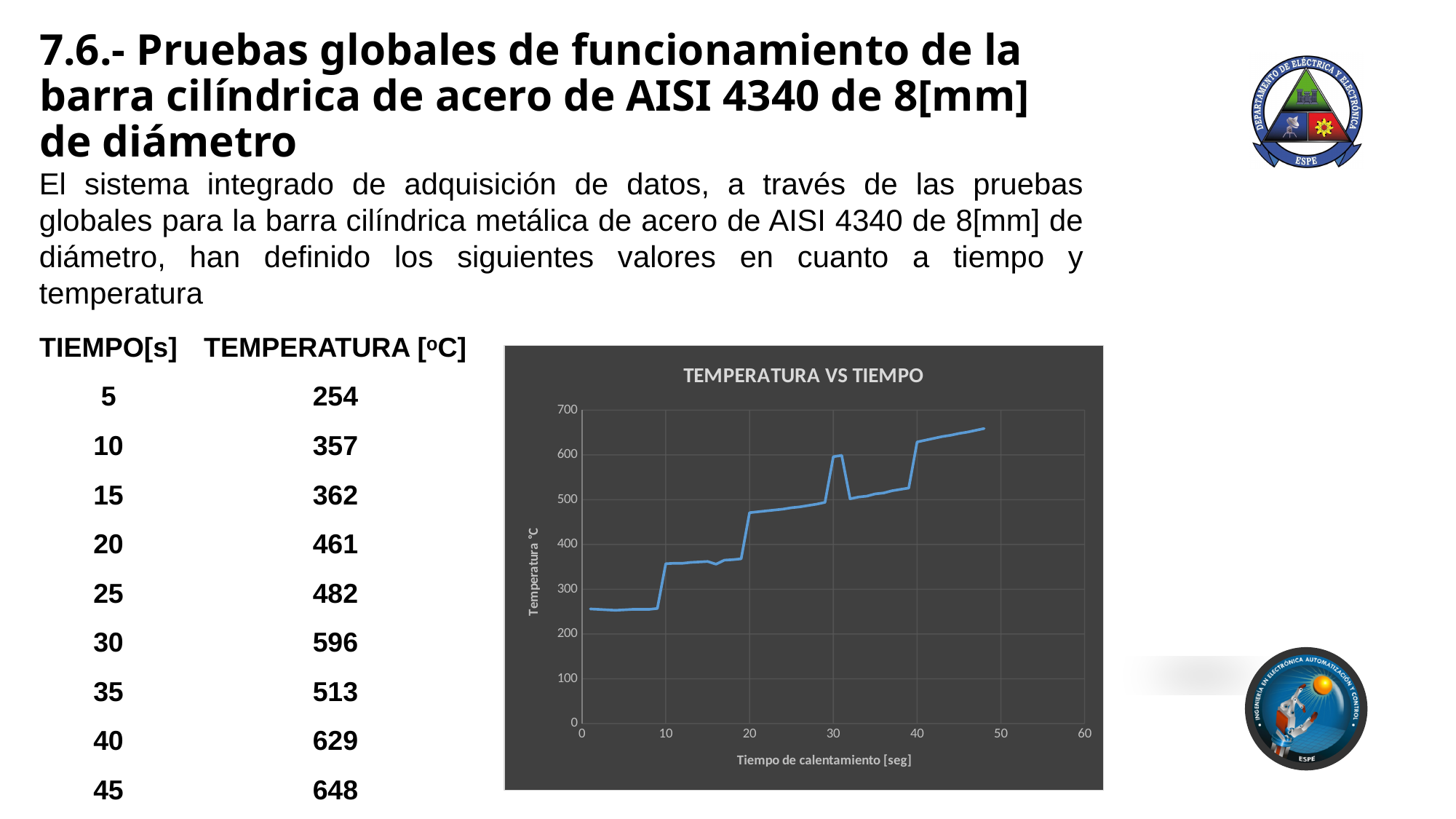
According to the table on the slide, at which time is the temperature highest? 45 According to the table on the slide, what is the temperature at 20 s? 461 What kind of chart is shown on the slide? line chart Using the table on the slide, what is the difference between the temperature at 45 s and at 5 s? 394 In the chart, is the temperature at 5 seg greater or less than 300? less According to the table on the slide, what is the temperature at 30 s? 596 In the chart, is the temperature at 40 seg greater or less than 600? greater In the chart, is the temperature at 20 seg greater or less than 400? greater According to the table on the slide, which has the higher temperature: 30 s or 35 s? 30 s What is the label of the x axis of the chart? Tiempo de calentamiento [seg] Overall, does the temperature rise or fall as the heating time increases along the x axis? rise What is the title of the chart? TEMPERATURA VS TIEMPO